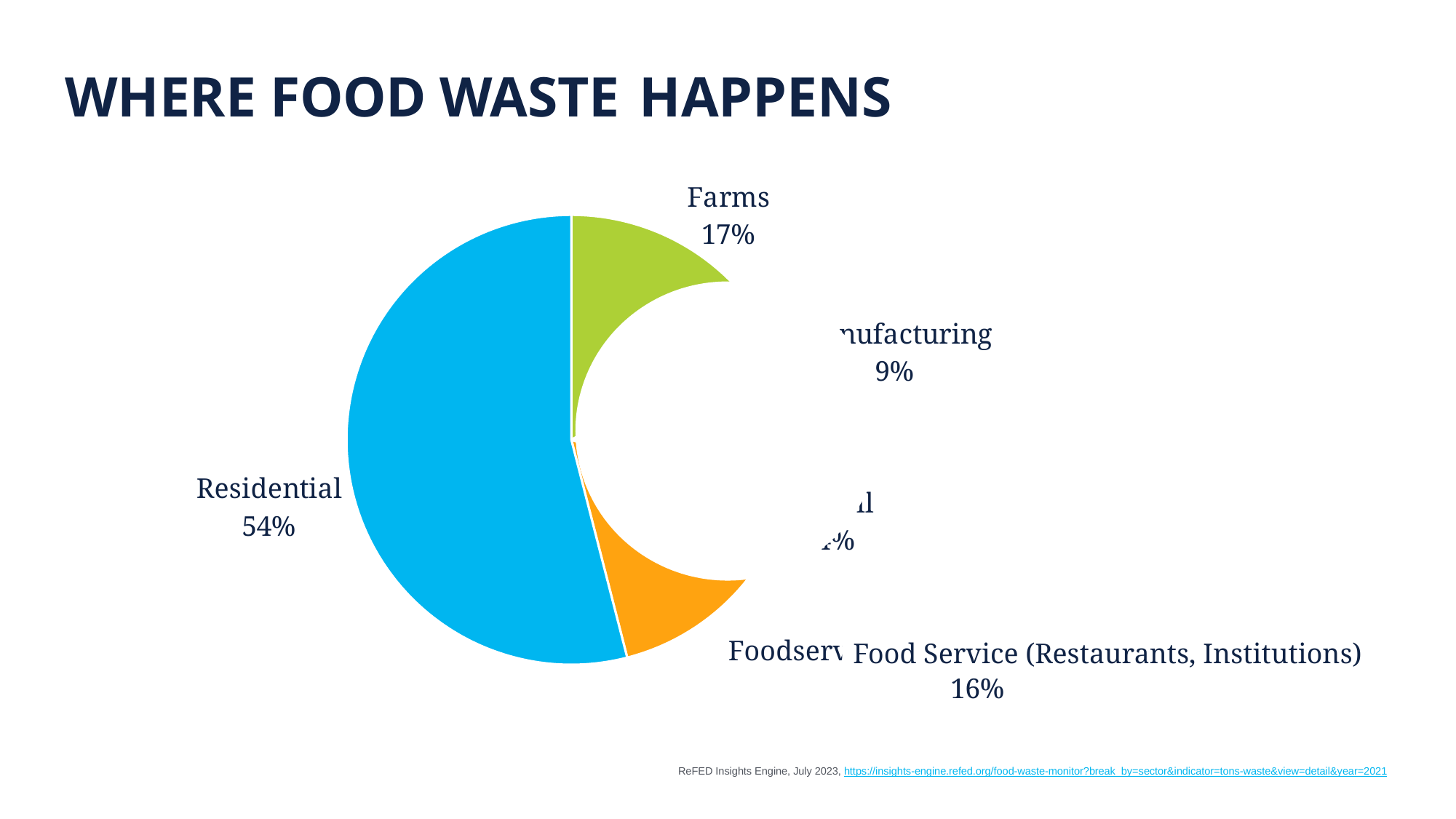
What percentage of food waste happens at Farms? 17% What colour is the Residential slice of the pie chart? Blue Which is larger, the share for Farms or the share for Food Service (Restaurants, Institutions)? Farms What share of food waste is Residential? 54% How many percentage points larger is the Residential share than the Farms share? 37% Which category accounts for the largest share of food waste? Residential What is the difference between the Farms share and the Food Service (Restaurants, Institutions) share? 1% What is the title of the slide? WHERE FOOD WASTE HAPPENS What percentage of food waste comes from Food Service (Restaurants, Institutions)? 16% What kind of chart is shown on the slide? Pie chart Which is larger, the Residential share or the Food Service (Restaurants, Institutions) share? Residential